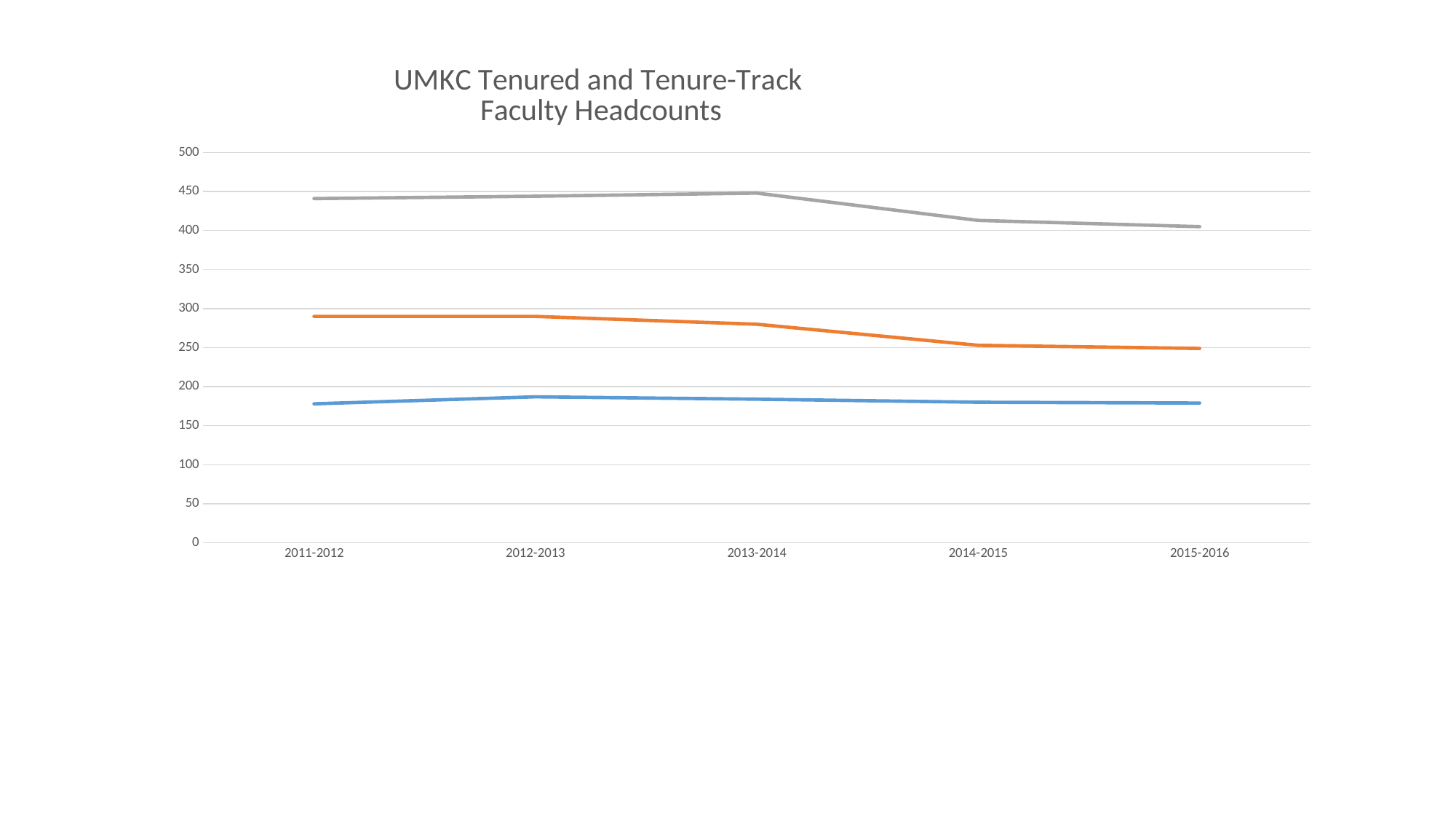
Is the value of the gray line for 2014-2015 greater or less than 450? less What kind of chart is shown on the slide? line chart Does the orange line rise or fall from 2012-2013 to 2014-2015? fall Is the value of the gray line for 2011-2012 greater or less than 400? greater Is the value of the blue line for 2012-2013 greater or less than 200? less Does the gray line rise or fall from 2013-2014 to 2015-2016? fall Which line is lowest across all years: the gray, orange or blue line? blue What is the title of the chart? UMKC Tenured and Tenure-Track Faculty Headcounts How many academic years are shown on the x axis? 5 Which line is highest across all years: the gray, orange or blue line? gray